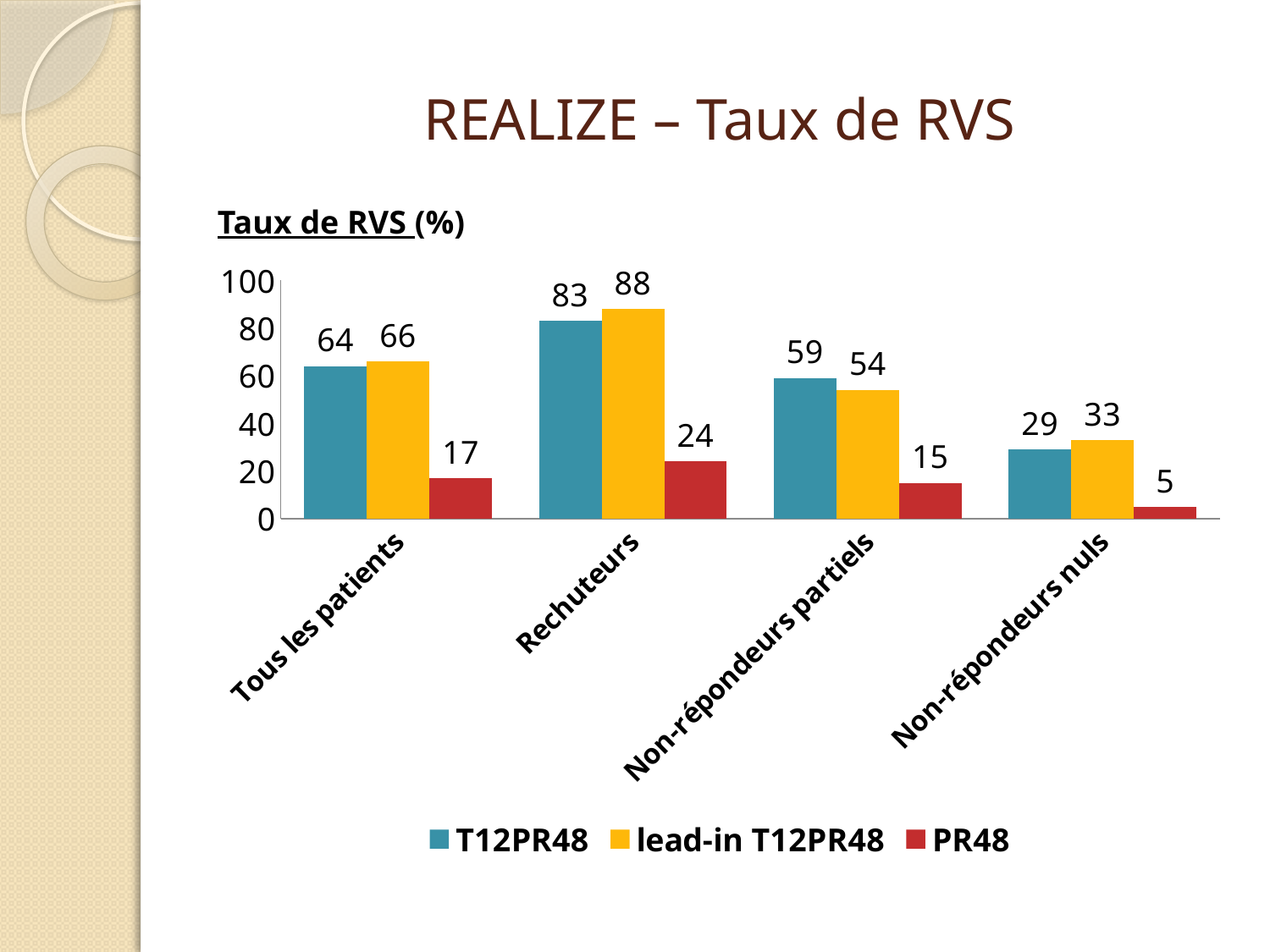
What is the value for PR48 in the Rechuteurs category? 24 Which is larger in the Non-répondeurs partiels category: T12PR48 or lead-in T12PR48? T12PR48 Which category has the highest value for the lead-in T12PR48 series? Rechuteurs How many categories are shown on the x axis? 4 How many series does the legend list? 3 What is the value for lead-in T12PR48 in the Non-répondeurs partiels category? 54 What kind of chart is shown on the slide? Bar chart What is the value for PR48 in the Non-répondeurs nuls category? 5 Which category has the lowest value for the T12PR48 series? Non-répondeurs nuls What is the value for T12PR48 in the Tous les patients category? 64 What is the difference between the lead-in T12PR48 and PR48 values in the Rechuteurs category? 64 What colour are the PR48 bars? Red